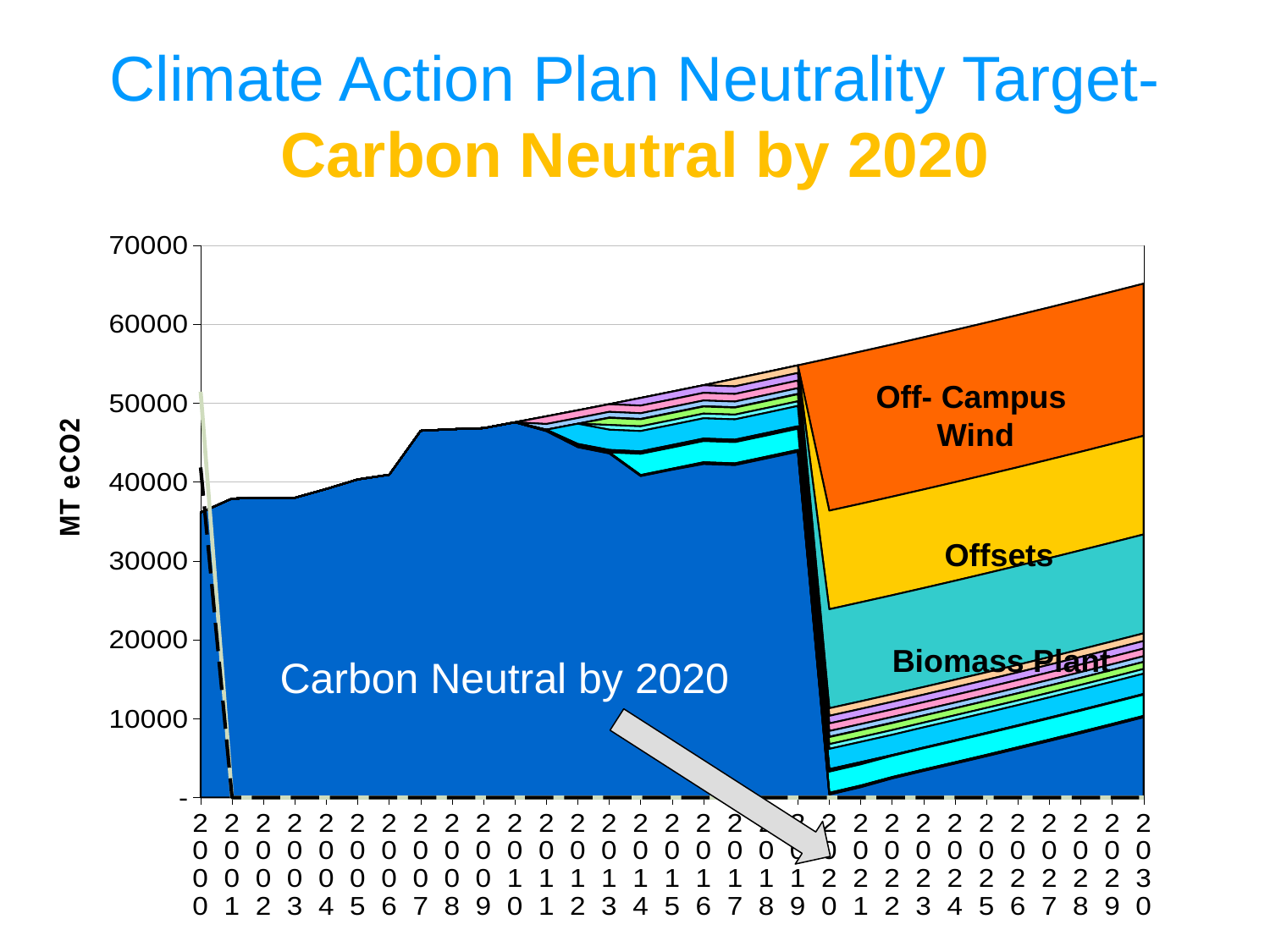
What is the first year shown on the x axis of the chart? 2000 Is the total height of the stacked areas in 2020 greater or less than 50000? greater What is the last year shown on the x axis of the chart? 2030 What is the label on the vertical axis of the chart? MT eCO2 Does the top of the stacked areas rise or fall from 2020 to 2030? rise Is the total height of the stacked areas in 2010 greater or less than 60000? less What is the highest value shown on the vertical axis of the chart? 70000 Is the total height of the stacked areas in 2010 greater or less than 40000? greater What kind of chart is shown on the slide? area chart How many years are shown along the x axis of the chart? 31 Which three areas are labelled by name inside the chart? Off- Campus Wind, Offsets, Biomass Plant